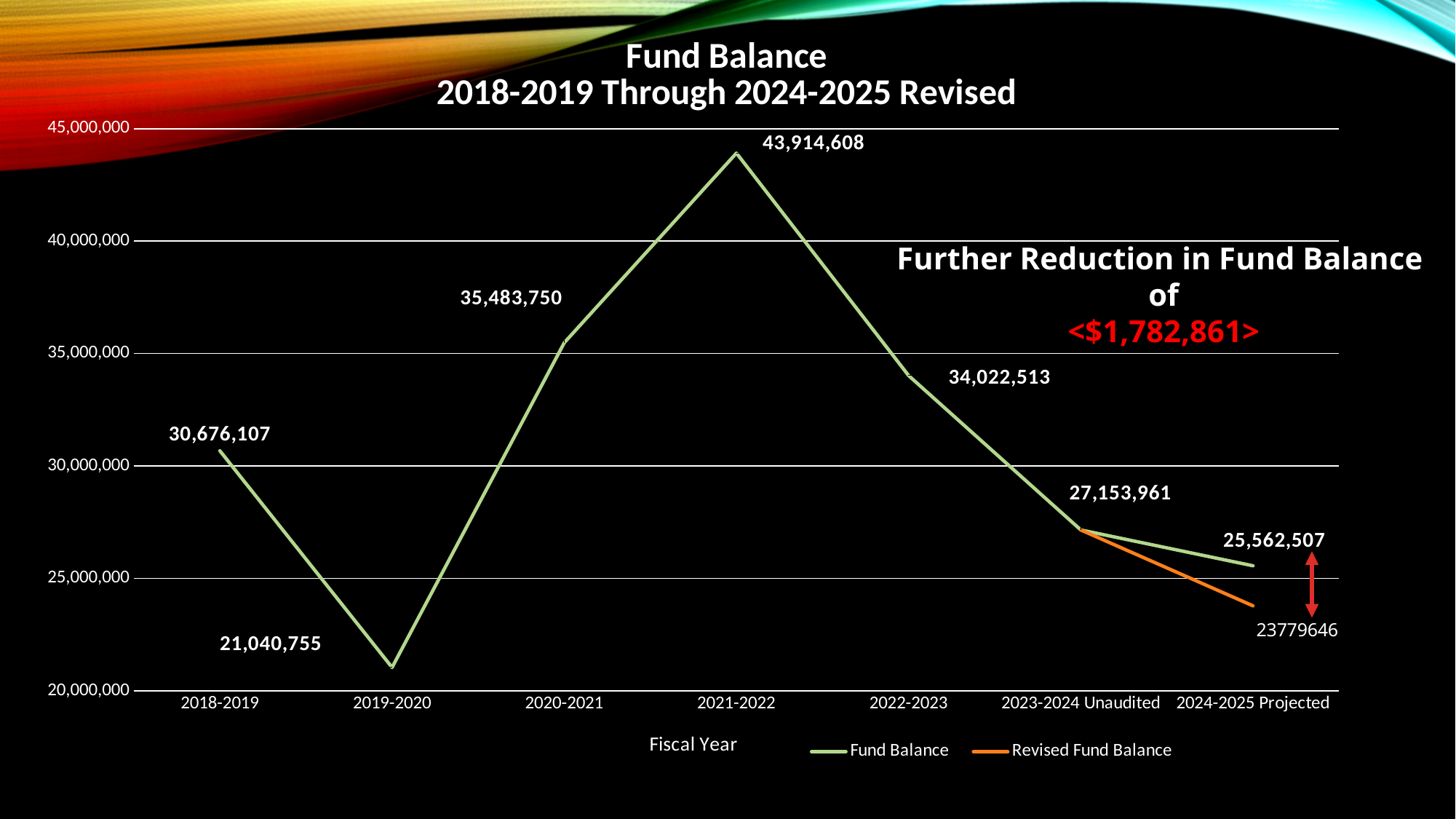
What is the difference between the Fund Balance for 2021-2022 and 2020-2021? 8,430,858 How many fiscal years are shown on the x axis? 7 Which fiscal year has the lowest Fund Balance? 2019-2020 What is the difference between the Fund Balance and the Revised Fund Balance for 2024-2025 Projected? 1,782,861 What is the Revised Fund Balance for 2024-2025 Projected? 23779646 Which fiscal year has the highest Fund Balance? 2021-2022 How many series does the legend list? 2 What is the Fund Balance for 2021-2022? 43,914,608 What kind of chart is shown on the slide? Line chart Which is larger, the Fund Balance for 2018-2019 or for 2022-2023? 2022-2023 What is the Fund Balance for 2023-2024 Unaudited? 27,153,961 What is the Fund Balance for 2019-2020? 21,040,755